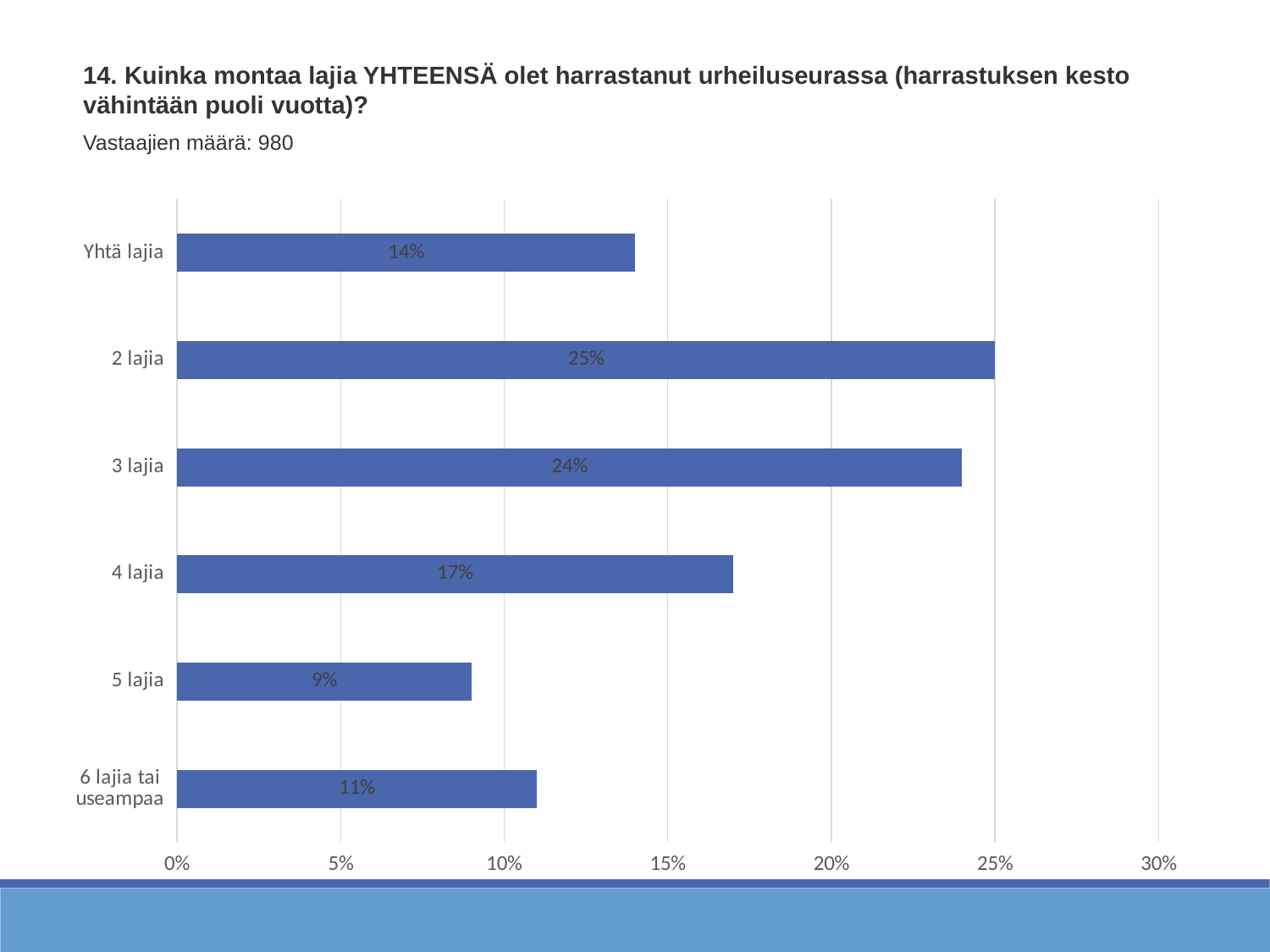
What is the value for "2 lajia"? 25% Which category has the highest value? 2 lajia What is the value for "6 lajia tai useampaa"? 11% Which is larger, the value for "Yhtä lajia" or the value for "4 lajia"? 4 lajia Which category has the lowest value? 5 lajia What kind of chart is shown on the slide? bar chart What is the difference between the values for "3 lajia" and "4 lajia"? 7% How many categories are shown on the chart? 6 Is the value for "5 lajia" greater or less than 10%? less What is the value for "Yhtä lajia"? 14% What is the number of respondents (Vastaajien määrä) stated on the slide? 980 What is the highest value shown on the x axis? 30%